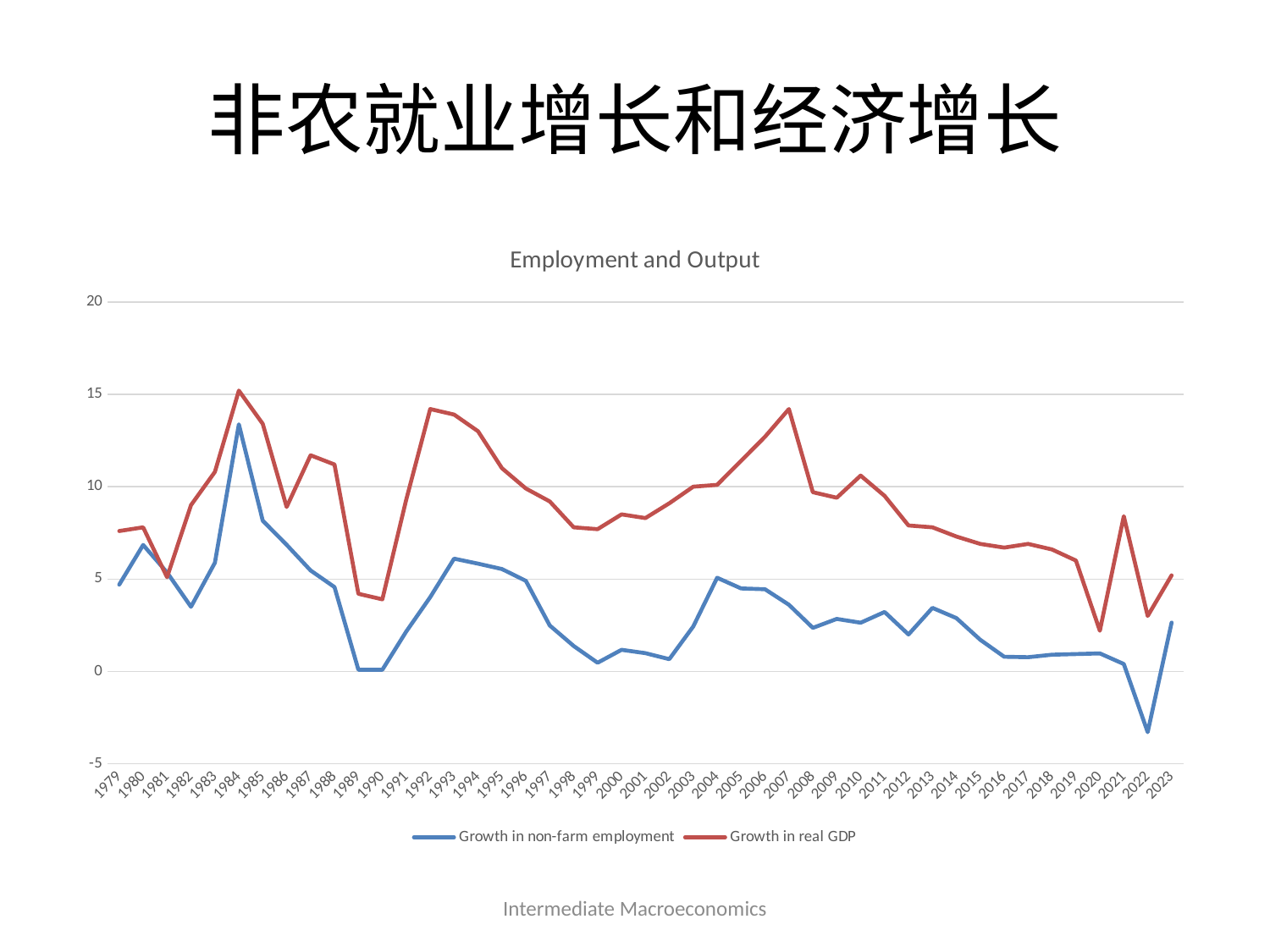
How many series does the legend list? 2 What kind of chart is shown on the slide? line chart In which year does Growth in non-farm employment reach its lowest value? 2022 In which year does Growth in non-farm employment reach its highest value? 1984 Is the value for Growth in non-farm employment in 1989 greater or less than 5? less Does Growth in non-farm employment rise or fall from 2004 to 2008? fall In which year does Growth in real GDP reach its highest value? 1984 What is the title shown above the chart? Employment and Output How many years are plotted along the x axis? 45 In 2007, which series has the larger value, Growth in non-farm employment or Growth in real GDP? Growth in real GDP Is the value for Growth in real GDP in 1992 greater or less than 10? greater Is the value for Growth in non-farm employment in 2020 greater or less than 0? greater